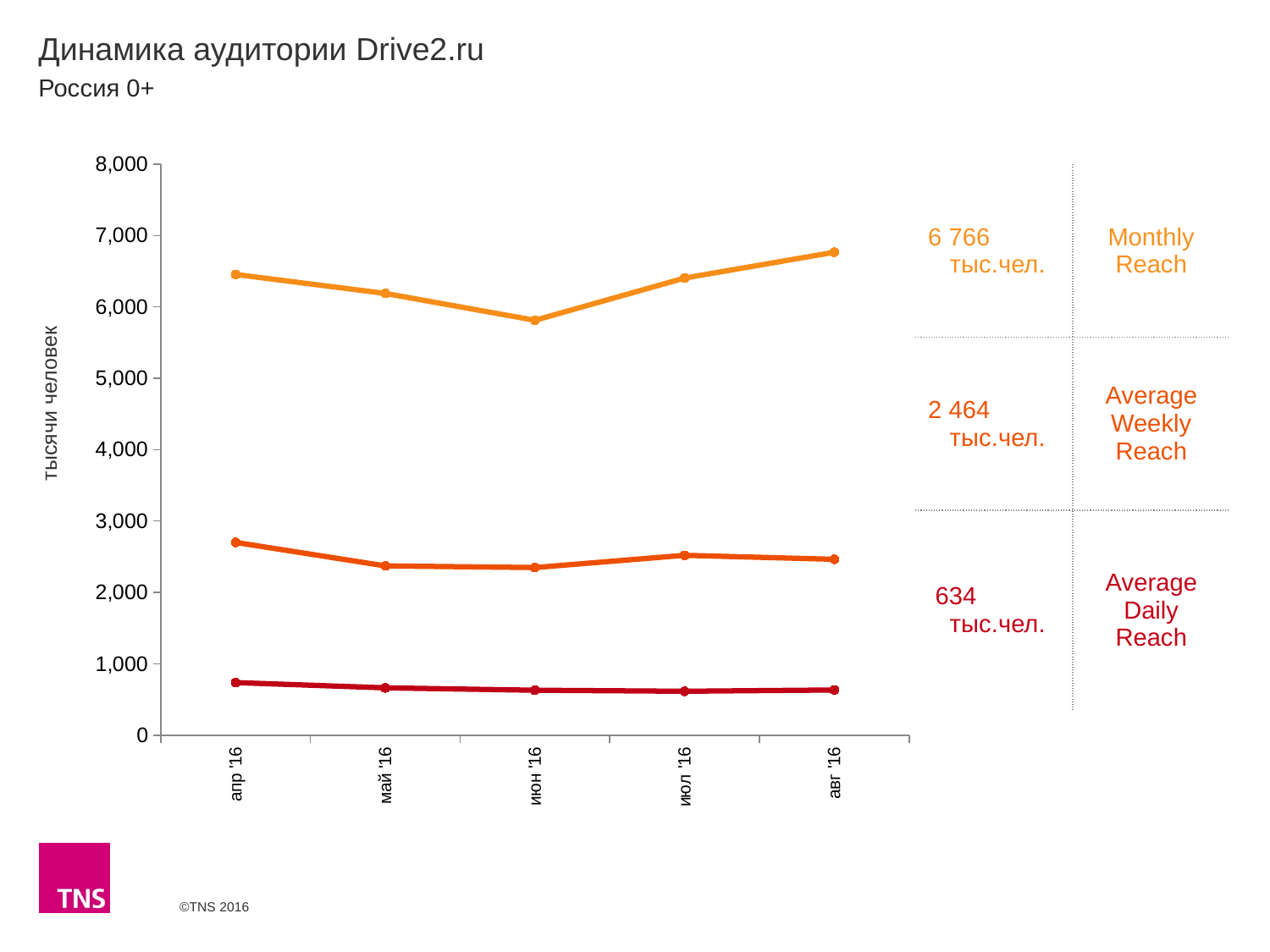
How many series (reach metrics) are plotted on the chart? 3 What is the unit label on the y axis? тысячи человек What kind of chart is shown on the slide? line chart In which month is the Monthly Reach line at its highest? авг '16 What Monthly Reach value is shown in the panel to the right of the chart? 6 766 тыс.чел. How many months are plotted along the x axis? 5 Which is larger in июл '16: Monthly Reach or Average Weekly Reach? Monthly Reach Is the Average Daily Reach value for май '16 greater or less than 1,000? less Is the Monthly Reach value for апр '16 greater or less than 6,000? greater Is the Average Weekly Reach value for июн '16 greater or less than 3,000? less In which month is the Monthly Reach line at its lowest? июн '16